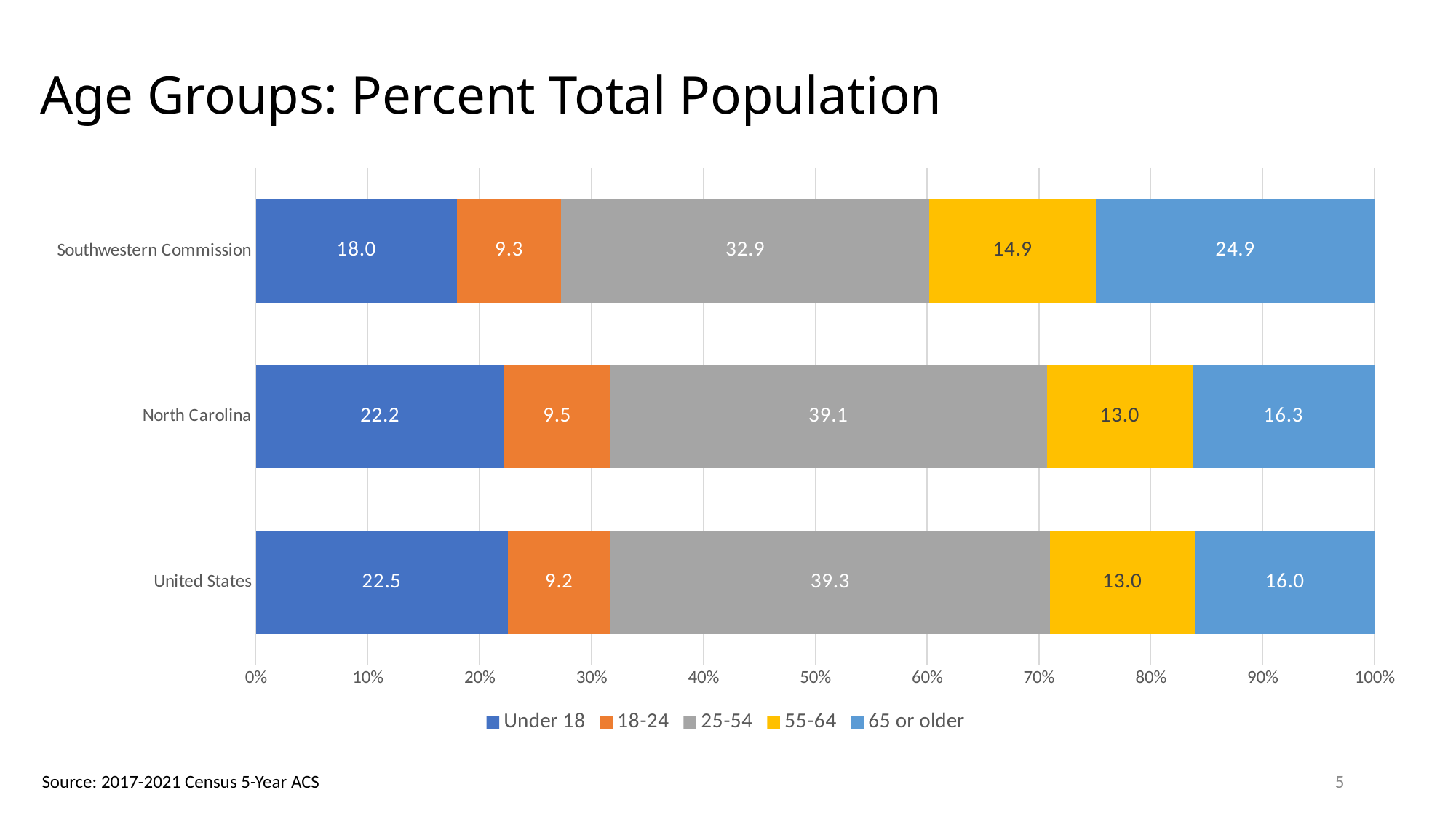
What is the value for the 25-54 age group for North Carolina? 39.1 Which colour represents the 55-64 age group in the legend? Yellow Which is larger: the Under 18 value for North Carolina or for Southwestern Commission? North Carolina Which region has the highest value for the 65 or older age group? Southwestern Commission What kind of chart is shown on the slide? Stacked bar chart What is the value for the 65 or older age group for Southwestern Commission? 24.9 What is the title of the chart? Age Groups: Percent Total Population What is the difference between the 65 or older values for Southwestern Commission and North Carolina? 8.6 What is the value for the Under 18 age group for United States? 22.5 How many age groups does the legend list? 5 Which region has the lowest value for the 25-54 age group? Southwestern Commission How many regions (bars) are shown in the chart? 3